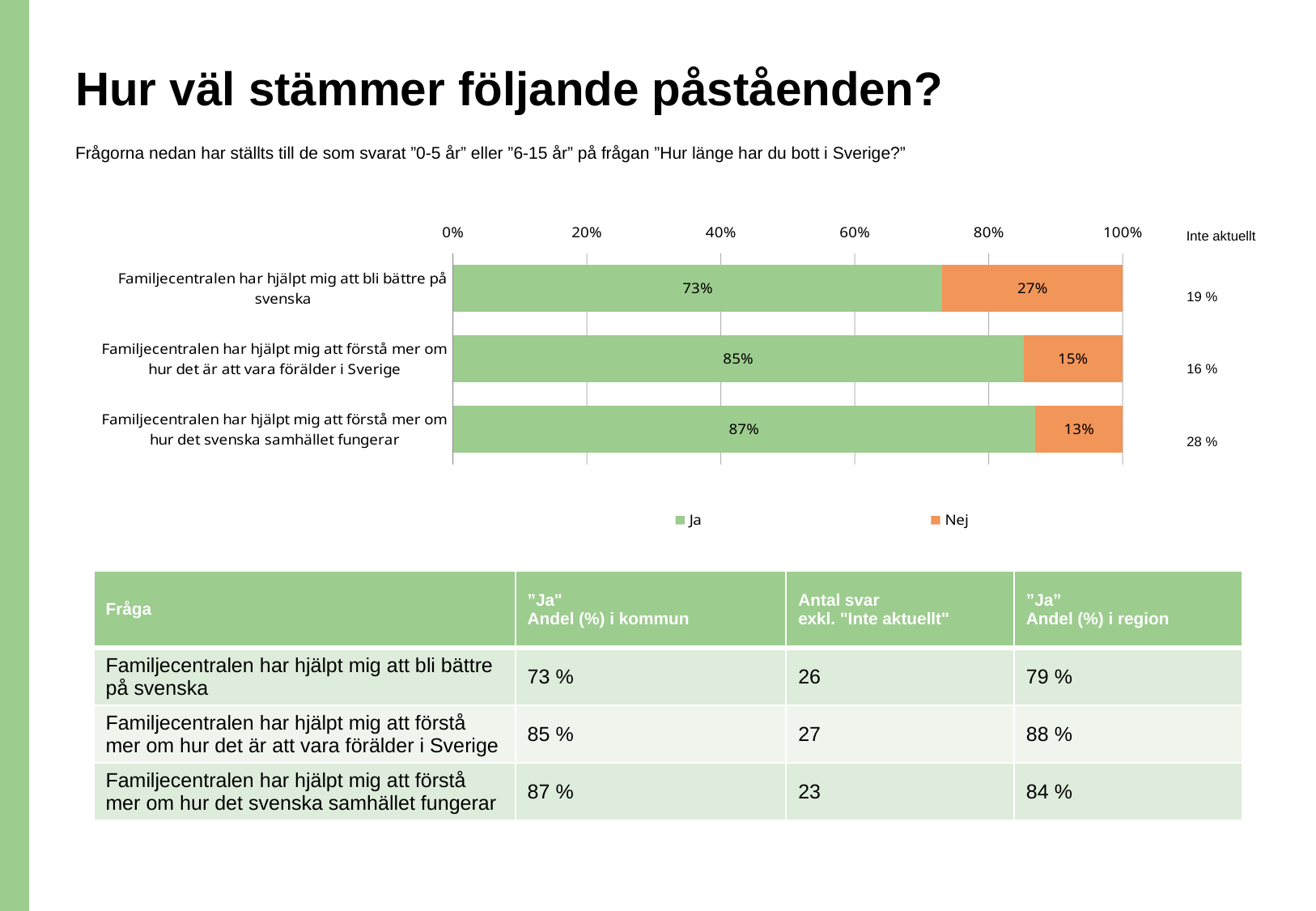
What is the total of the "Ja" and "Nej" segments for "bli bättre på svenska"? 100% How many statements are shown in the chart? 3 What percentage answered "Ja" to "Familjecentralen har hjälpt mig att förstå mer om hur det svenska samhället fungerar"? 87% Which is larger: the "Ja" share for "förstå mer om hur det är att vara förälder i Sverige" or for "bli bättre på svenska"? förstå mer om hur det är att vara förälder i Sverige What percentage answered "Nej" to "Familjecentralen har hjälpt mig att förstå mer om hur det är att vara förälder i Sverige"? 15% What colour represents "Nej" in the chart? Orange What kind of chart is shown? Stacked bar chart What percentage answered "Ja" to "Familjecentralen har hjälpt mig att bli bättre på svenska"? 73% Which statement has the lowest "Ja" share? Familjecentralen har hjälpt mig att bli bättre på svenska What is the difference in "Nej" share between "bli bättre på svenska" and "förstå mer om hur det svenska samhället fungerar"? 14 percentage points How many series does the legend list? 2 Which statement has the highest "Ja" share? Familjecentralen har hjälpt mig att förstå mer om hur det svenska samhället fungerar